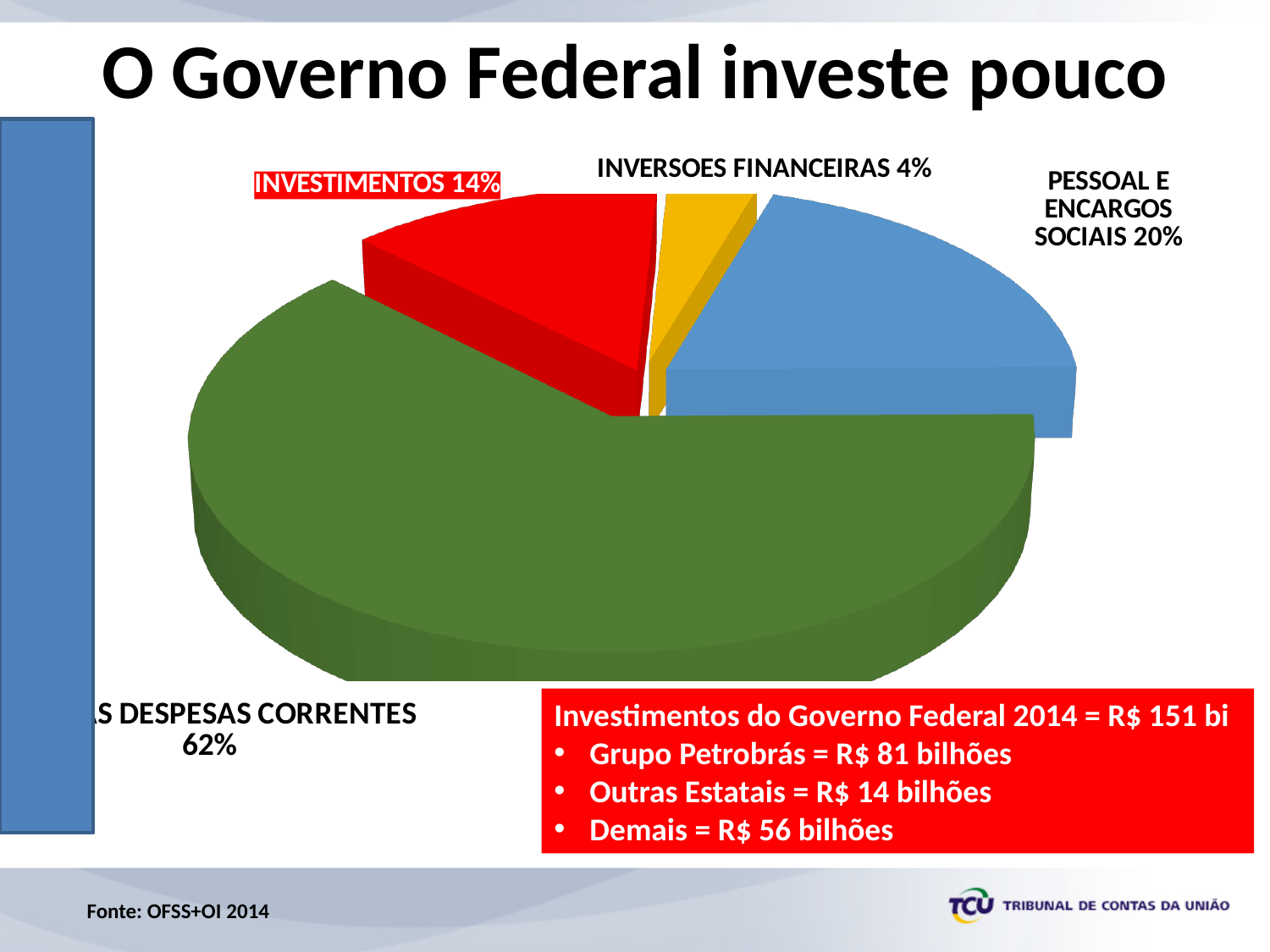
Which is larger, the INVESTIMENTOS slice or the INVERSOES FINANCEIRAS slice? INVESTIMENTOS What kind of chart is shown on the slide? Pie chart What percentage does the PESSOAL E ENCARGOS SOCIAIS slice represent? 20% Which slice of the pie is the smallest? INVERSOES FINANCEIRAS What is the difference in percentage points between PESSOAL E ENCARGOS SOCIAIS and INVESTIMENTOS? 6 What colour is the INVESTIMENTOS slice? Red What percentage does the INVESTIMENTOS slice represent? 14% What percentage does the INVERSOES FINANCEIRAS slice represent? 4% What percentage is shown for the green DESPESAS CORRENTES slice? 62% What is the title of the slide containing the pie chart? O Governo Federal investe pouco Which slice of the pie is the largest? DESPESAS CORRENTES How many slices does the pie chart have? 4